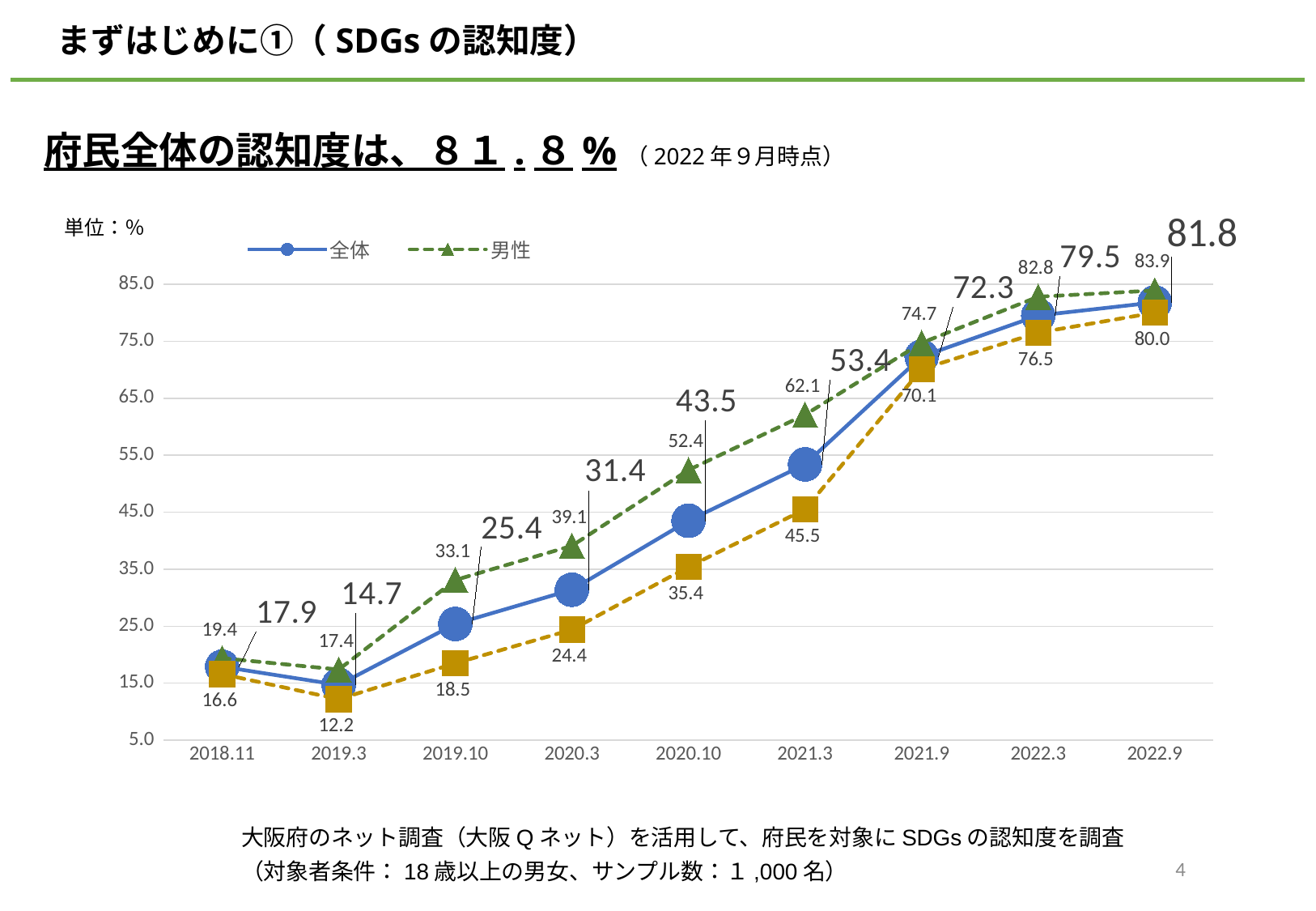
At which date is the 全体 series lowest? 2019.3 Does the 全体 series rise or fall from 2019.3 to 2022.9? rise What is the value for 男性 at 2018.11? 19.4 What kind of chart is shown on the slide? line chart What is the value for 全体 at 2022.9? 81.8 At 2021.9, which is larger: 全体 or 男性? 男性 What is the value for 男性 at 2021.3? 62.1 What is the difference between 男性 and 全体 at 2020.10? 8.9 How many time points are shown on the x axis? 9 At which date is the 全体 series highest? 2022.9 What is the value for 全体 at 2019.3? 14.7 How much did the 全体 value increase from 2018.11 to 2022.9? 63.9